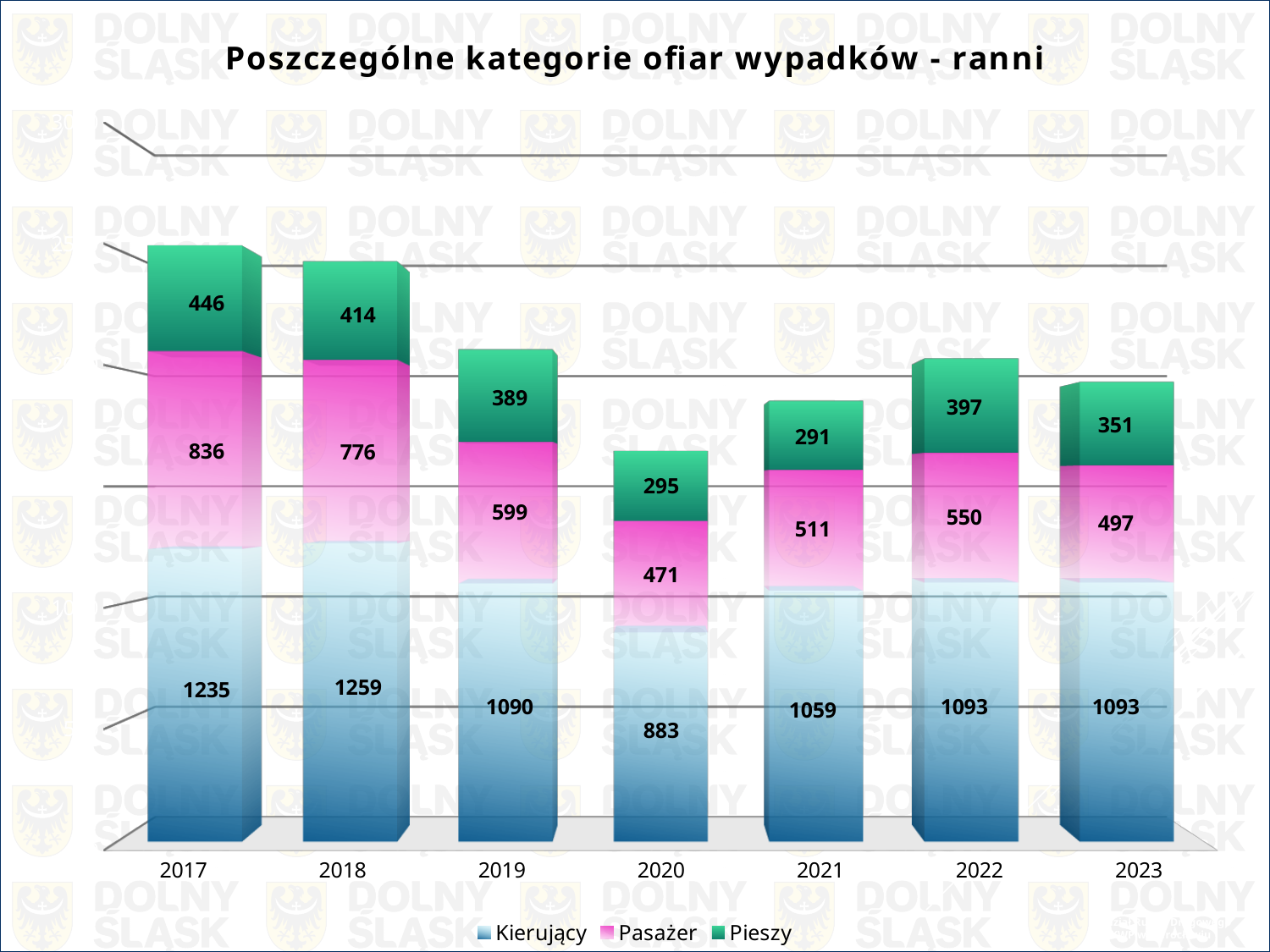
What is the value for Pasażer in 2017? 836 What is the total of the stacked bar for 2020? 1649 What is the value for Kierujący in 2020? 883 How many years are shown on the x axis? 7 How many series does the legend list? 3 What is the title of the chart? Poszczególne kategorie ofiar wypadków - ranni In which year is the Kierujący value highest? 2018 What is the difference between the Pasażer values for 2018 and 2019? 177 Which is larger, the Pieszy value for 2019 or for 2023? 2019 In which year is the Pieszy value lowest? 2021 What is the value for Pieszy in 2022? 397 What kind of chart is this? stacked bar chart